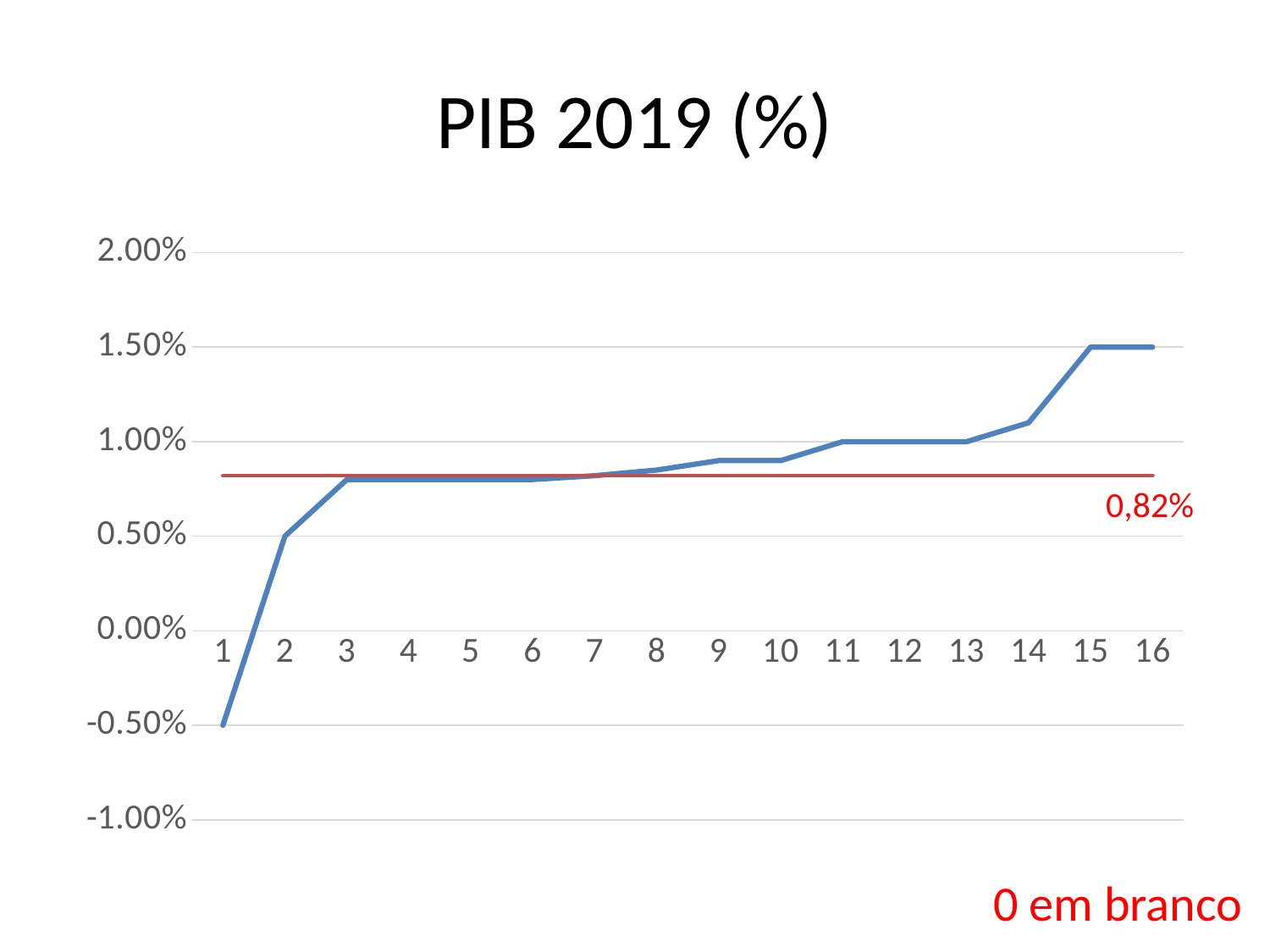
Is the value at point 14 greater or less than 1.00%? greater What is the value at point 1? -0.50% What is the value at point 2? 0.50% Is the value at point 5 greater or less than 1.00%? less What is the title of the chart? PIB 2019 (%) What is the value at point 16? 1.50% Which point has the lowest value? 1 What value is labelled on the red horizontal line? 0,82% How many points are plotted along the x axis? 16 What is the difference between the value at point 16 and the value at point 1? 2.00% What is the value at point 12? 1.00% What kind of chart is shown on the slide? line chart